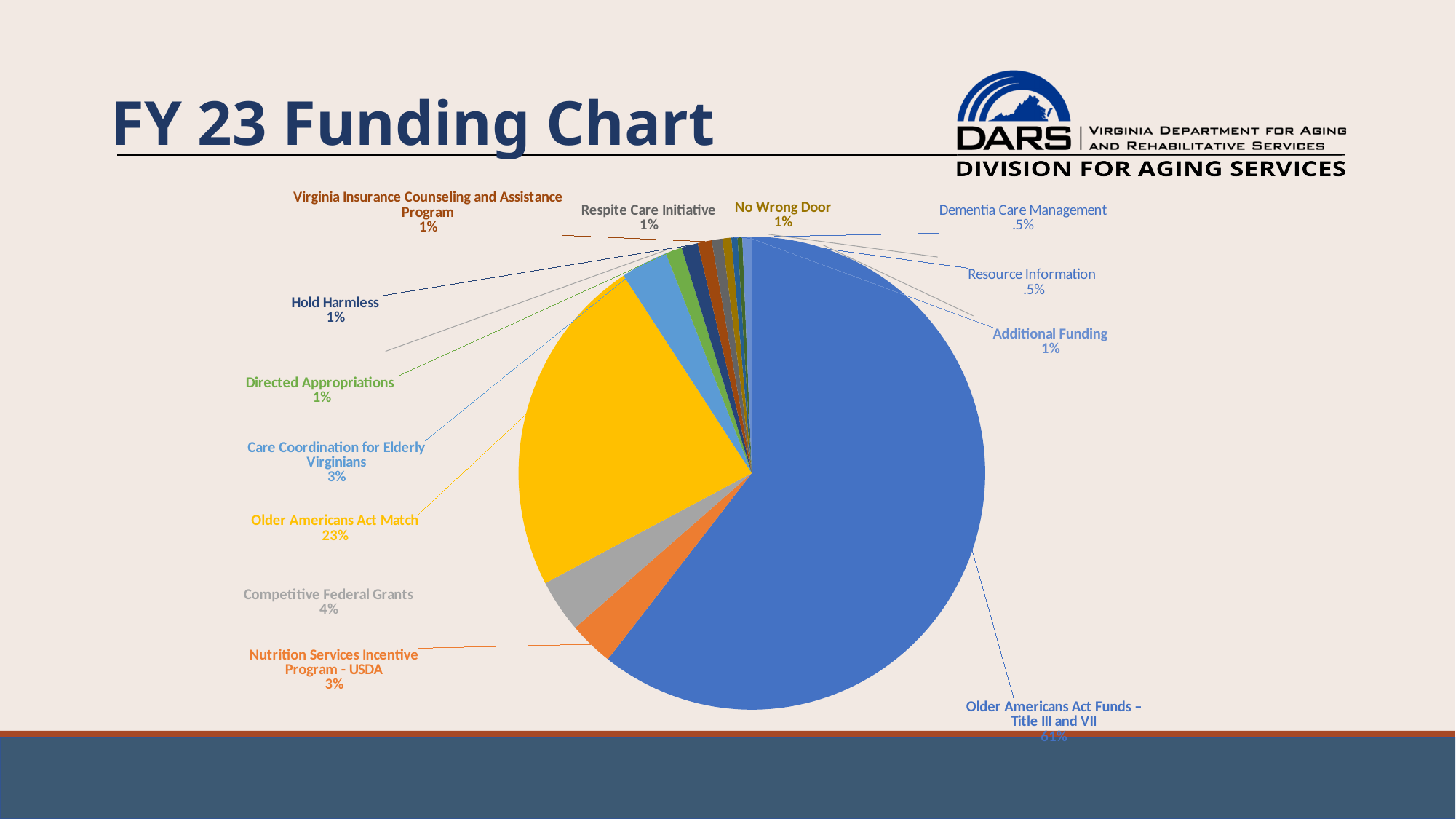
What share of funding is Hold Harmless? 1% What is the title of the slide? FY 23 Funding Chart Which funding source has the largest share of the pie? Older Americans Act Funds – Title III and VII What share of funding is Dementia Care Management? .5% How many funding categories are shown in the pie chart? 13 What share of funding is Competitive Federal Grants? 4% What type of chart is shown on the slide? pie chart What share of funding is Nutrition Services Incentive Program - USDA? 3% What is the difference in percentage points between Older Americans Act Match and Competitive Federal Grants? 19% What share of funding is Older Americans Act Match? 23% Which has a larger share: Care Coordination for Elderly Virginians or Competitive Federal Grants? Competitive Federal Grants What share of funding is Resource Information? .5%